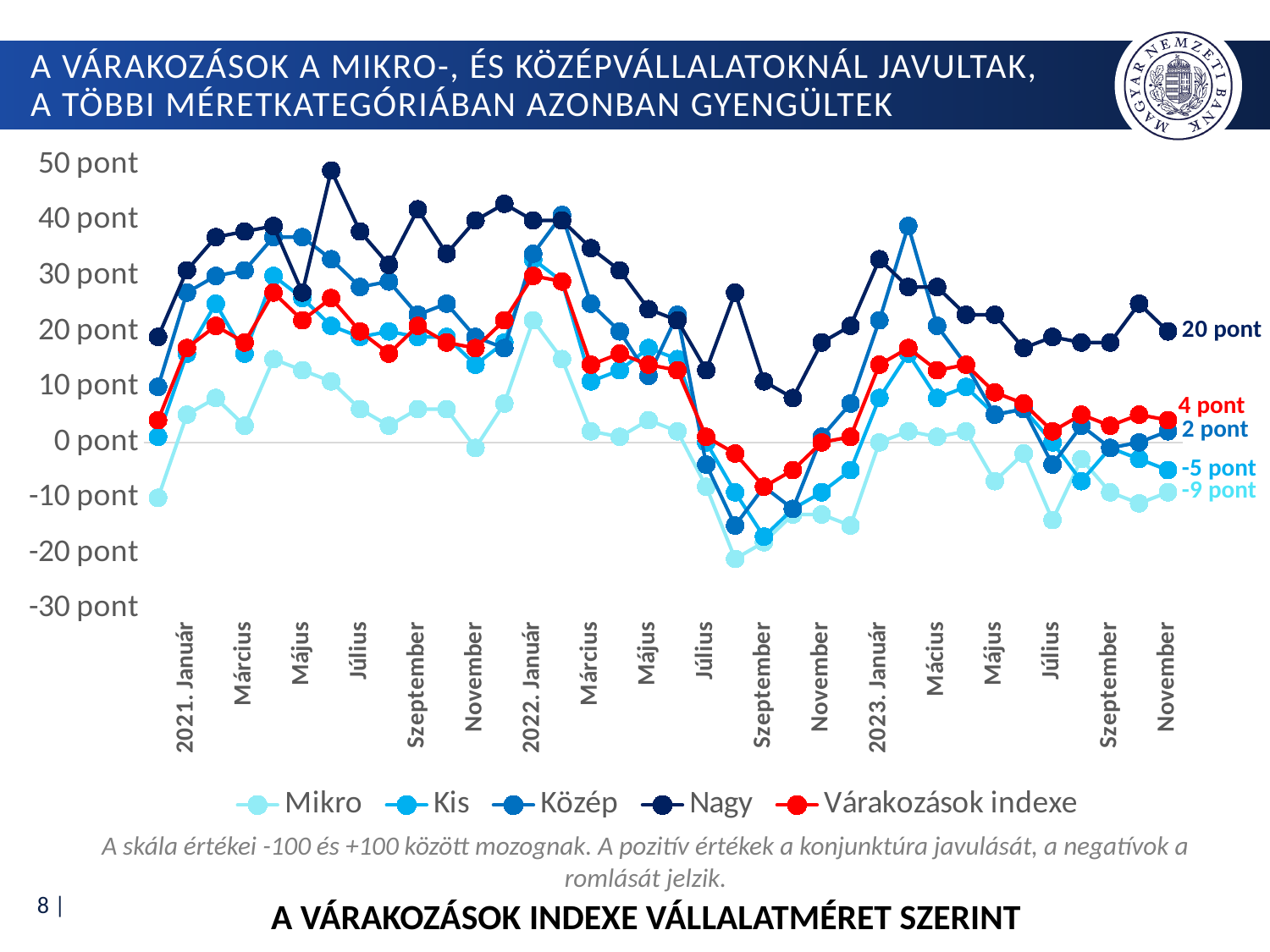
What kind of chart is shown on the slide? line chart How many series does the legend list? 5 Is the peak value of the Nagy series in 2021 greater or less than 40 pont? greater What is the difference between the Nagy and Mikro values at the last data point? 29 pont Does the Nagy series rise or fall from 2023. Január to November 2023? fall What is the value of the Kis series at the last data point? -5 pont What is the value of the Mikro series at the last data point? -9 pont Which series has the highest value at the last data point? Nagy What is the value of the Nagy series at the last data point (November 2023)? 20 pont At the last data point, which is larger: the Kis value or the Mikro value? Kis What is the value of the Várakozások indexe series at the last data point? 4 pont Which series has the lowest value at the last data point? Mikro